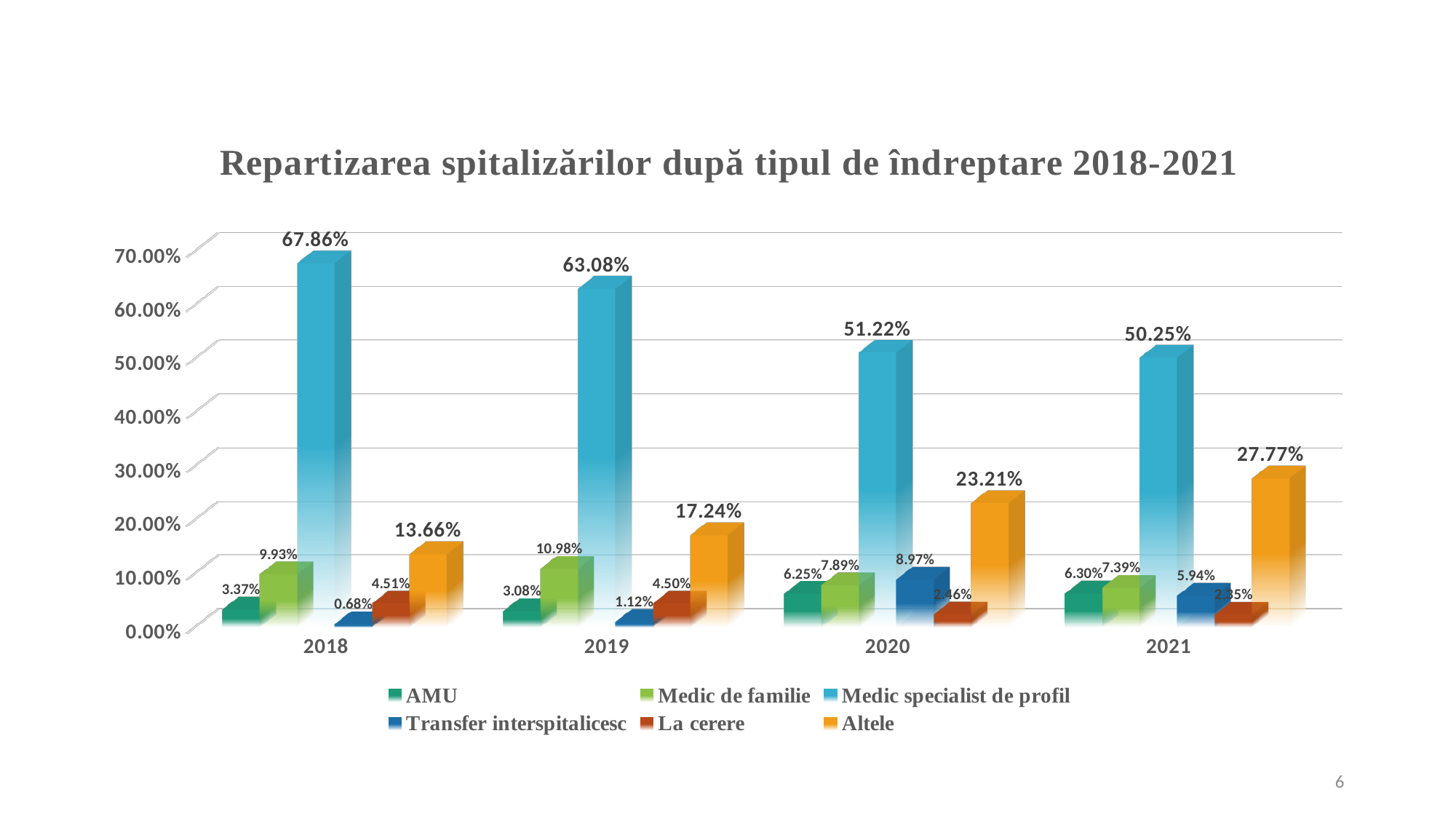
What is the value for Transfer interspitalicesc in 2018? 0.68% What is the difference between the Altele values for 2020 and 2019? 5.97% Does the value for Medic specialist de profil rise or fall from 2018 to 2021? fall What is the difference between the Medic specialist de profil values for 2018 and 2021? 17.61% What is the value for Medic specialist de profil in 2018? 67.86% Does the value for Altele rise or fall from 2018 to 2021? rise In 2020, which is larger: Transfer interspitalicesc or Medic de familie? Transfer interspitalicesc How many years are shown on the x axis? 4 Which series has the lowest value in 2019? Transfer interspitalicesc How many series does the legend list? 6 What is the value for Altele in 2021? 27.77% In which year is the value for Medic specialist de profil highest? 2018